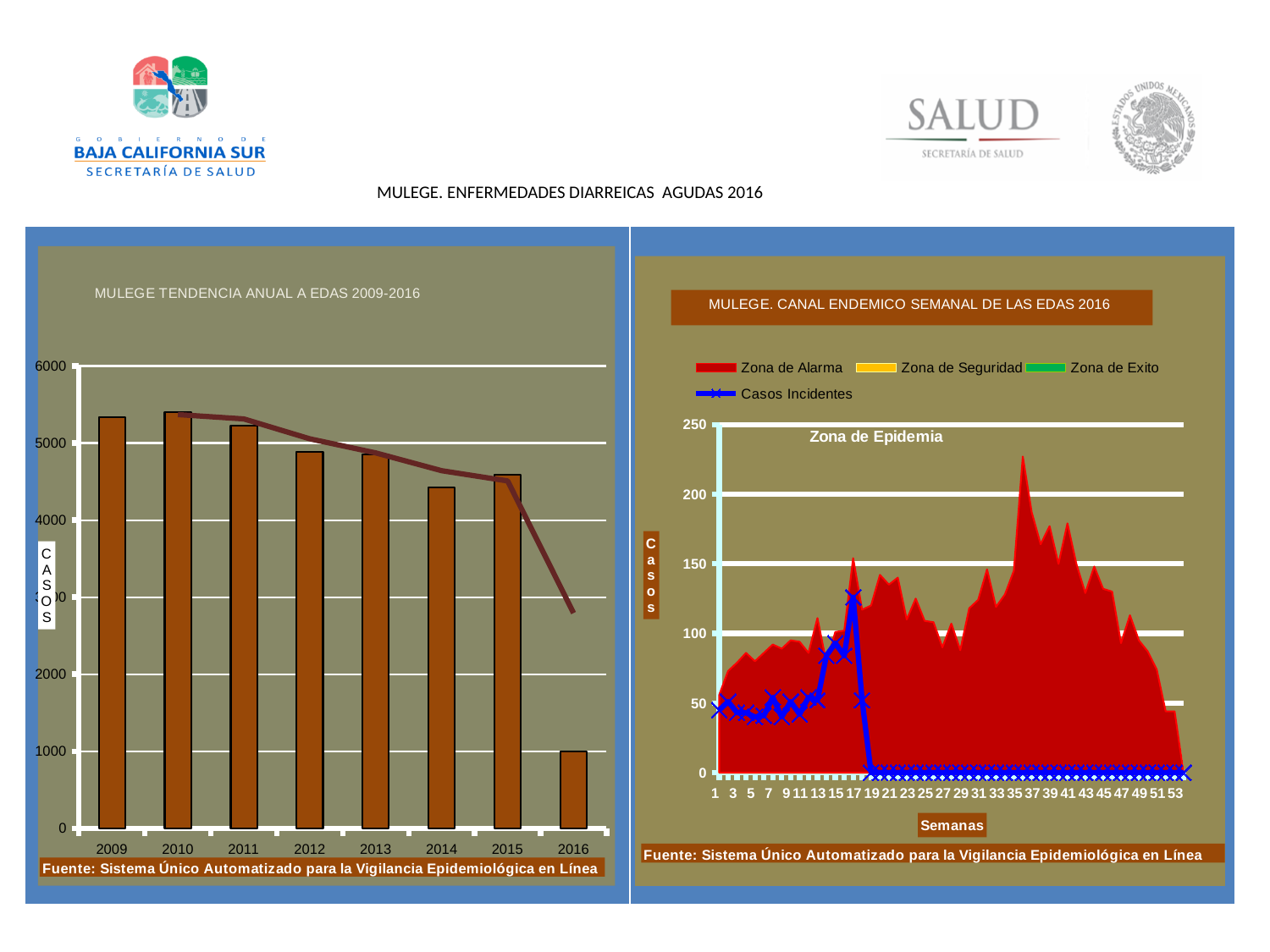
In the left chart 'MULEGE TENDENCIA ANUAL A EDAS 2009-2016', is the value for 2014 greater or less than 5000? less In the left chart 'MULEGE TENDENCIA ANUAL A EDAS 2009-2016', is the value for 2016 greater or less than 2000? less In the right chart 'MULEGE. CANAL ENDEMICO SEMANAL DE LAS EDAS 2016', what is the highest value shown on the y axis? 250 What kind of chart is the left chart, 'MULEGE TENDENCIA ANUAL A EDAS 2009-2016'? bar chart In the left chart 'MULEGE TENDENCIA ANUAL A EDAS 2009-2016', which year has the lowest value? 2016 In the right chart 'MULEGE. CANAL ENDEMICO SEMANAL DE LAS EDAS 2016', is the peak of the Casos Incidentes line around week 17 greater or less than 100? greater How many entries does the legend of the right chart 'MULEGE. CANAL ENDEMICO SEMANAL DE LAS EDAS 2016' list? 4 In the left chart 'MULEGE TENDENCIA ANUAL A EDAS 2009-2016', which is larger, the value for 2009 or the value for 2014? 2009 In the left chart 'MULEGE TENDENCIA ANUAL A EDAS 2009-2016', do the values generally rise or fall from 2009 to 2016? fall In the left chart 'MULEGE TENDENCIA ANUAL A EDAS 2009-2016', how many years are shown on the x axis? 8 In the right chart 'MULEGE. CANAL ENDEMICO SEMANAL DE LAS EDAS 2016', what is the label of the x axis? Semanas